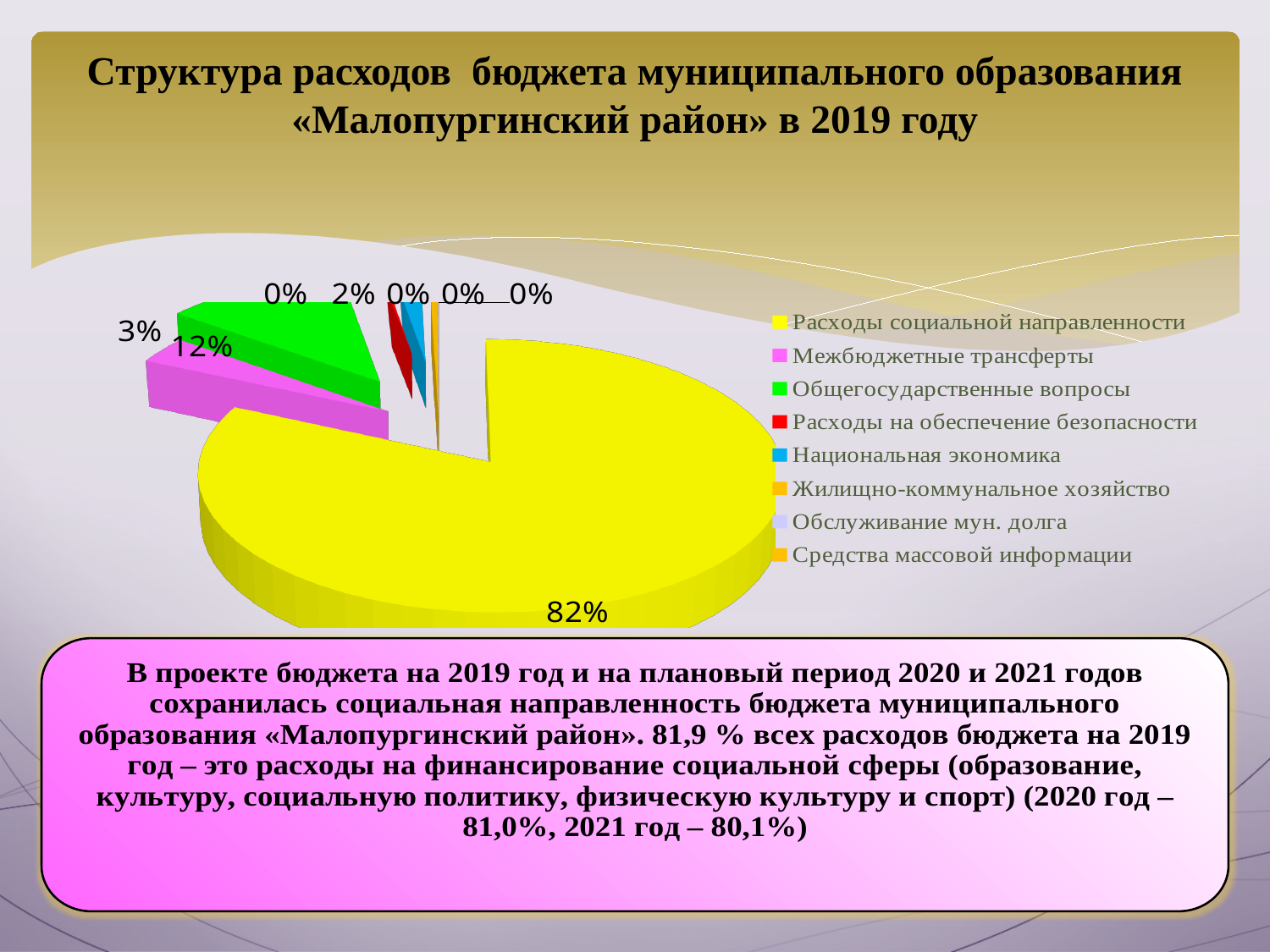
What share of the pie is labelled for Расходы социальной направленности? 82% What share of the pie is labelled for Общегосударственные вопросы? 12% What share of the pie is labelled for Межбюджетные трансферты? 3% What colour is the slice for Межбюджетные трансферты? Pink What is the difference in percentage points between the share for Расходы социальной направленности and the share for Межбюджетные трансферты? 79 What colour is the slice for Расходы социальной направленности? Yellow What is the difference in percentage points between the share for Межбюджетные трансферты and the share for Общегосударственные вопросы? 9 Which is larger: the share for Межбюджетные трансферты or the share for Общегосударственные вопросы? Общегосударственные вопросы Which category has the largest share of the pie? Расходы социальной направленности What kind of chart is shown on the slide? Pie chart How many categories does the legend list? 8